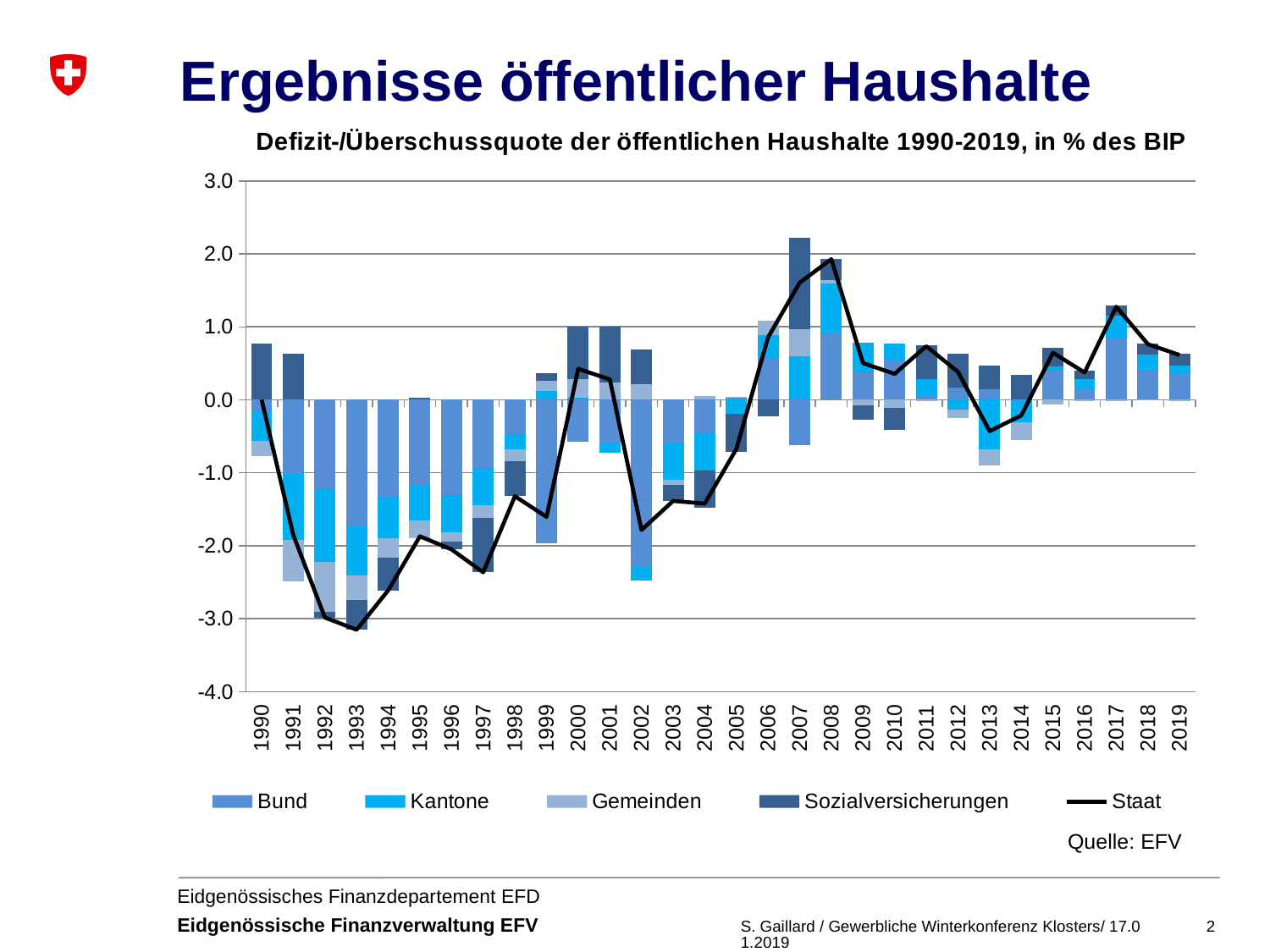
What source is given below the chart? Quelle: EFV Does the Staat line rise or fall from 2002 to 2008? rise In which year does the Staat line reach its lowest value? 1993 What is the title of the chart? Defizit-/Überschussquote der öffentlichen Haushalte 1990-2019, in % des BIP What kind of chart is this? Stacked bar chart with a line How many series does the legend list? 5 How many years are shown on the x axis? 30 Which year has the higher Staat value, 2007 or 2002? 2007 Is the Staat value for 2002 greater or less than -1.0? less In which year does the Staat line reach its highest value? 2008 Is the Staat value for 1993 greater or less than -2.0? less Is the Staat value for 2008 greater or less than 1.0? greater